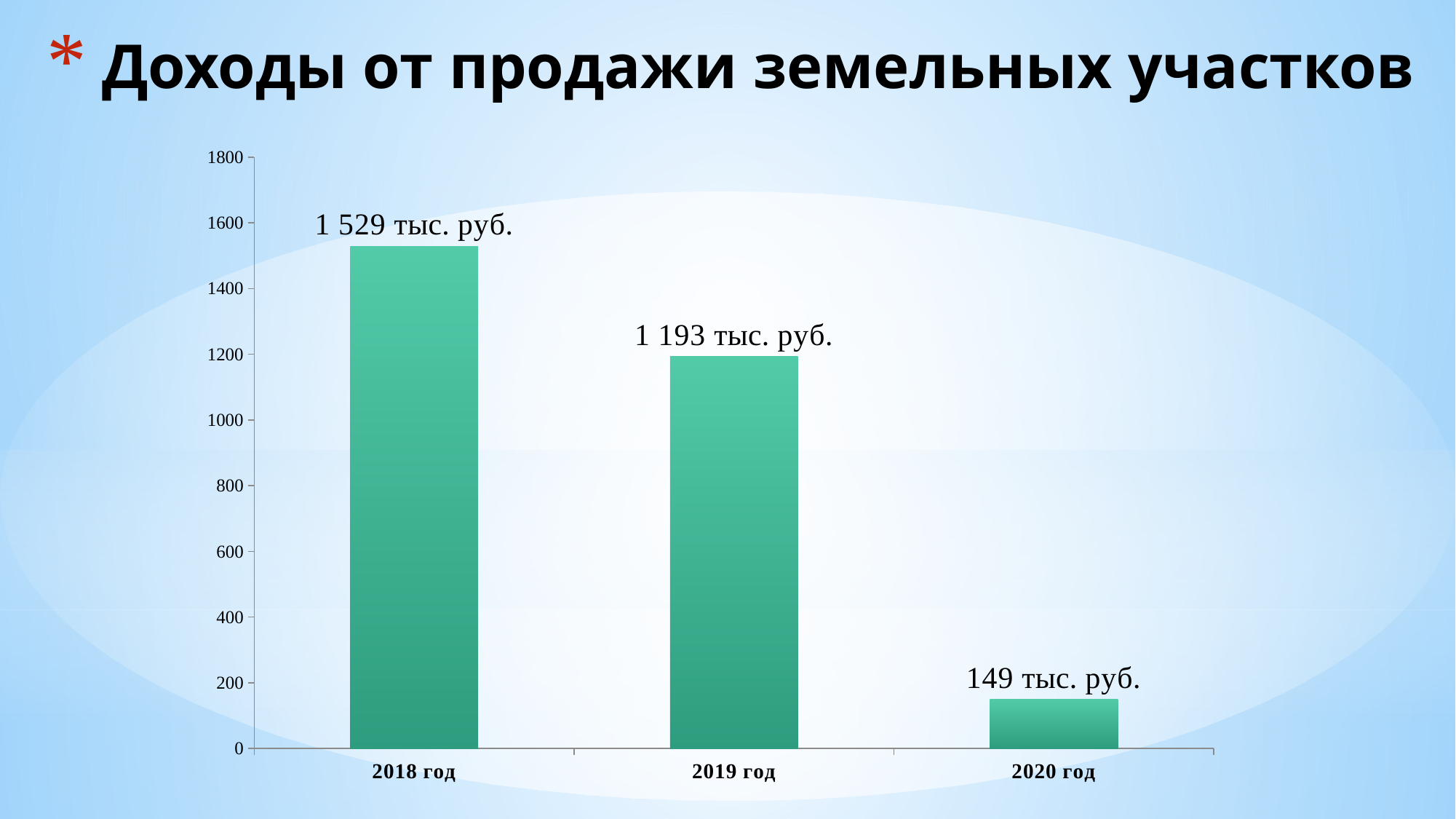
What is the difference between the values for 2019 год and 2020 год? 1 044 тыс. руб. Do the values rise or fall from 2018 год to 2020 год? fall Which year has the lowest value? 2020 год What is the value for 2020 год? 149 тыс. руб. What kind of chart is shown on the slide? bar chart How many years are shown on the chart? 3 What is the difference between the values for 2018 год and 2019 год? 336 тыс. руб. What is the value for 2019 год? 1 193 тыс. руб. Is the value for 2019 год greater or less than 1000? greater Which year has the highest value? 2018 год Which is larger, the value for 2019 год or 2020 год? 2019 год What is the value for 2018 год? 1 529 тыс. руб.